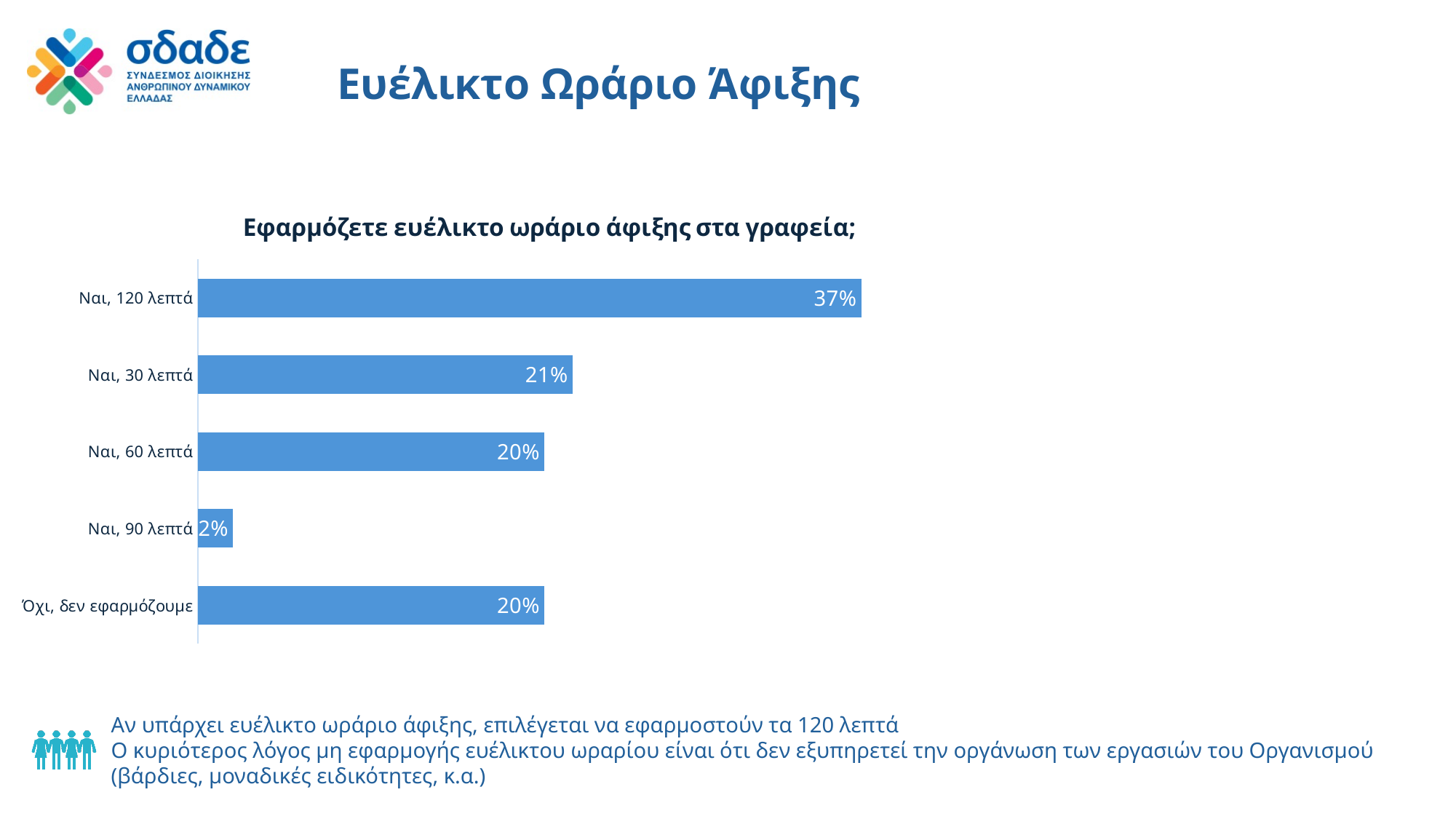
What is the difference between the values for "Ναι, 60 λεπτά" and "Ναι, 90 λεπτά"? 18% How many categories does the chart show? 5 What is the value for "Όχι, δεν εφαρμόζουμε"? 20% What is the value for "Ναι, 30 λεπτά"? 21% What is the value for "Ναι, 90 λεπτά"? 2% What is the value for "Ναι, 120 λεπτά"? 37% What is the title of the chart? Εφαρμόζετε ευέλικτο ωράριο άφιξης στα γραφεία; Which category has the lowest value? Ναι, 90 λεπτά Which is larger, the value for "Ναι, 30 λεπτά" or the value for "Ναι, 90 λεπτά"? Ναι, 30 λεπτά Which category has the highest value? Ναι, 120 λεπτά What is the difference between the values for "Ναι, 120 λεπτά" and "Ναι, 30 λεπτά"? 16% What kind of chart is shown on the slide? Bar chart